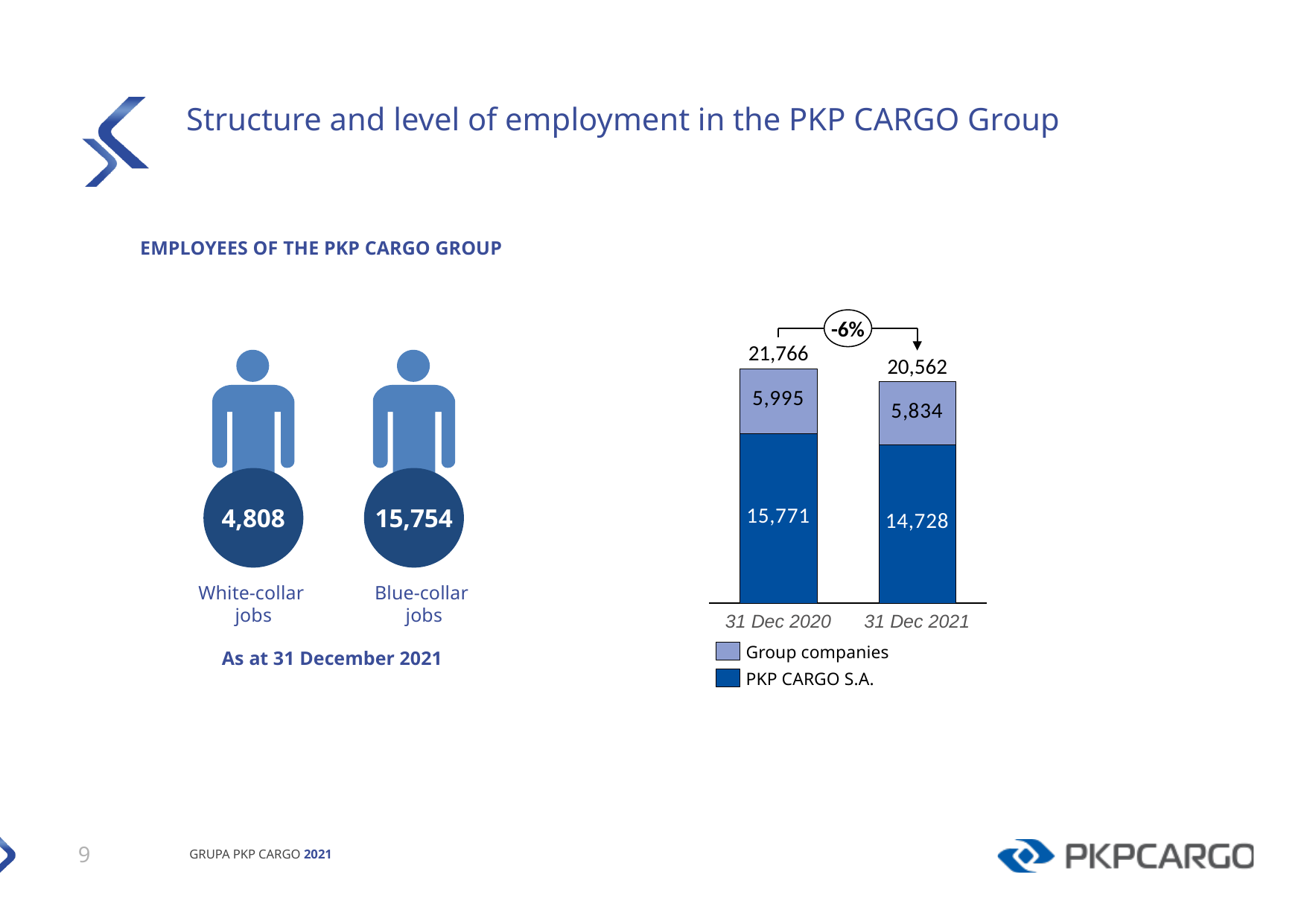
What is the total of the stacked bar for 31 Dec 2020? 21,766 What is the value for PKP CARGO S.A. at 31 Dec 2020? 15,771 What kind of chart is shown on the slide? Stacked bar chart Do the total employee numbers rise or fall from 31 Dec 2020 to 31 Dec 2021? Fall What is the difference between the PKP CARGO S.A. values at 31 Dec 2020 and 31 Dec 2021? 1,043 Which series is shown in the darker blue colour in the bar chart? PKP CARGO S.A. What is the total of the stacked bar for 31 Dec 2021? 20,562 How many series does the legend of the bar chart list? 2 What is the value for Group companies at 31 Dec 2021? 5,834 Which date has the higher total number of employees, 31 Dec 2020 or 31 Dec 2021? 31 Dec 2020 How many bars (dates) are shown in the bar chart? 2 What percentage change is shown between the two bars in the chart? -6%